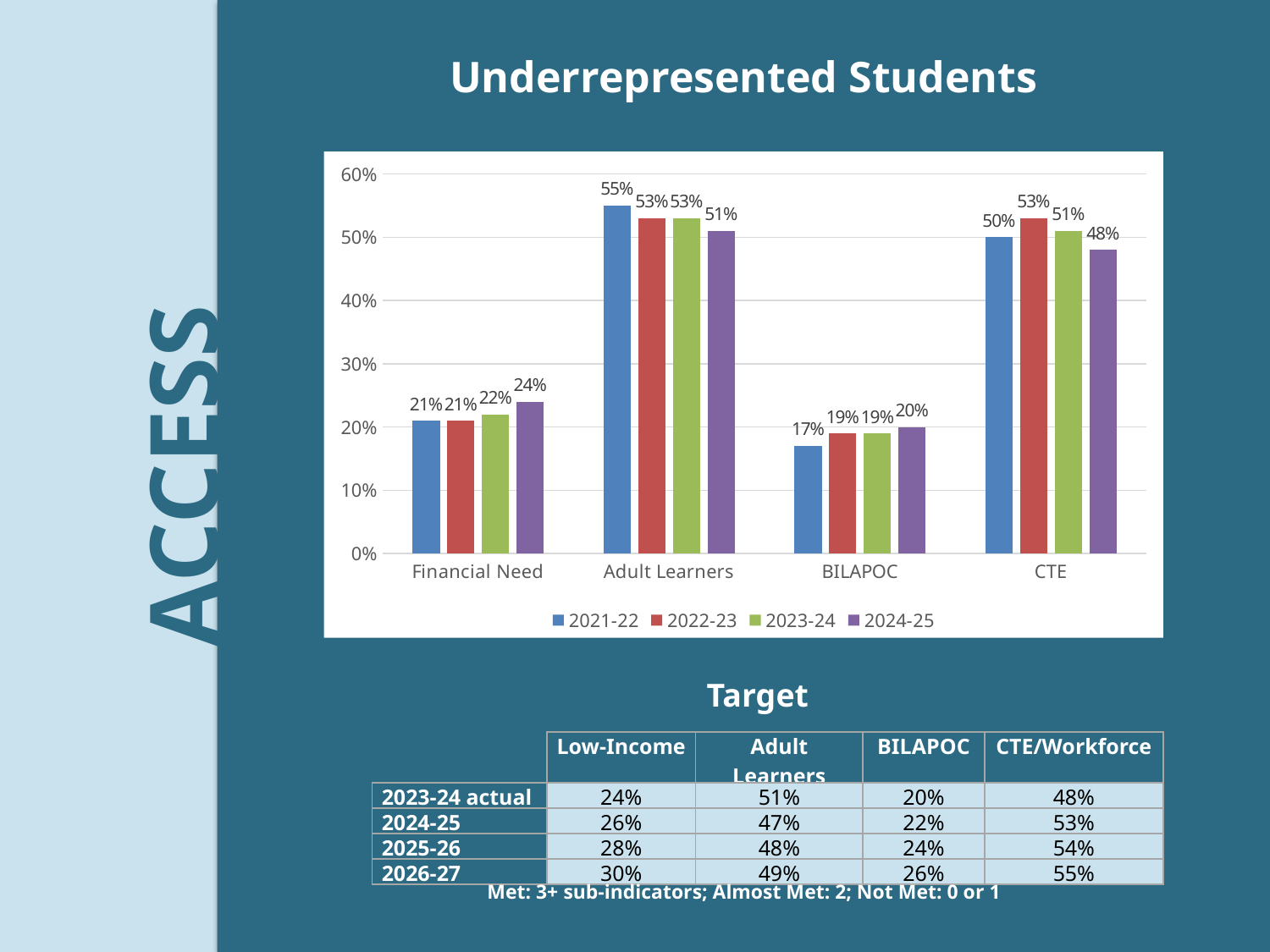
Which category has the highest value in the 2024-25 series? Adult Learners Which is larger: the 2024-25 value for Financial Need or the 2024-25 value for BILAPOC? Financial Need What is the value for Financial Need in the 2023-24 series? 22% What is the difference between the 2021-22 and 2024-25 values for Adult Learners? 4% What is the value for BILAPOC in the 2024-25 series? 20% Do the values for CTE rise or fall from 2022-23 to 2024-25? Fall What is the value for CTE in the 2022-23 series? 53% What kind of chart is shown? Bar chart What is the value for Adult Learners in the 2021-22 series? 55% Which category has the lowest value in the 2021-22 series? BILAPOC How many categories are shown on the x axis? 4 How many series does the legend list? 4